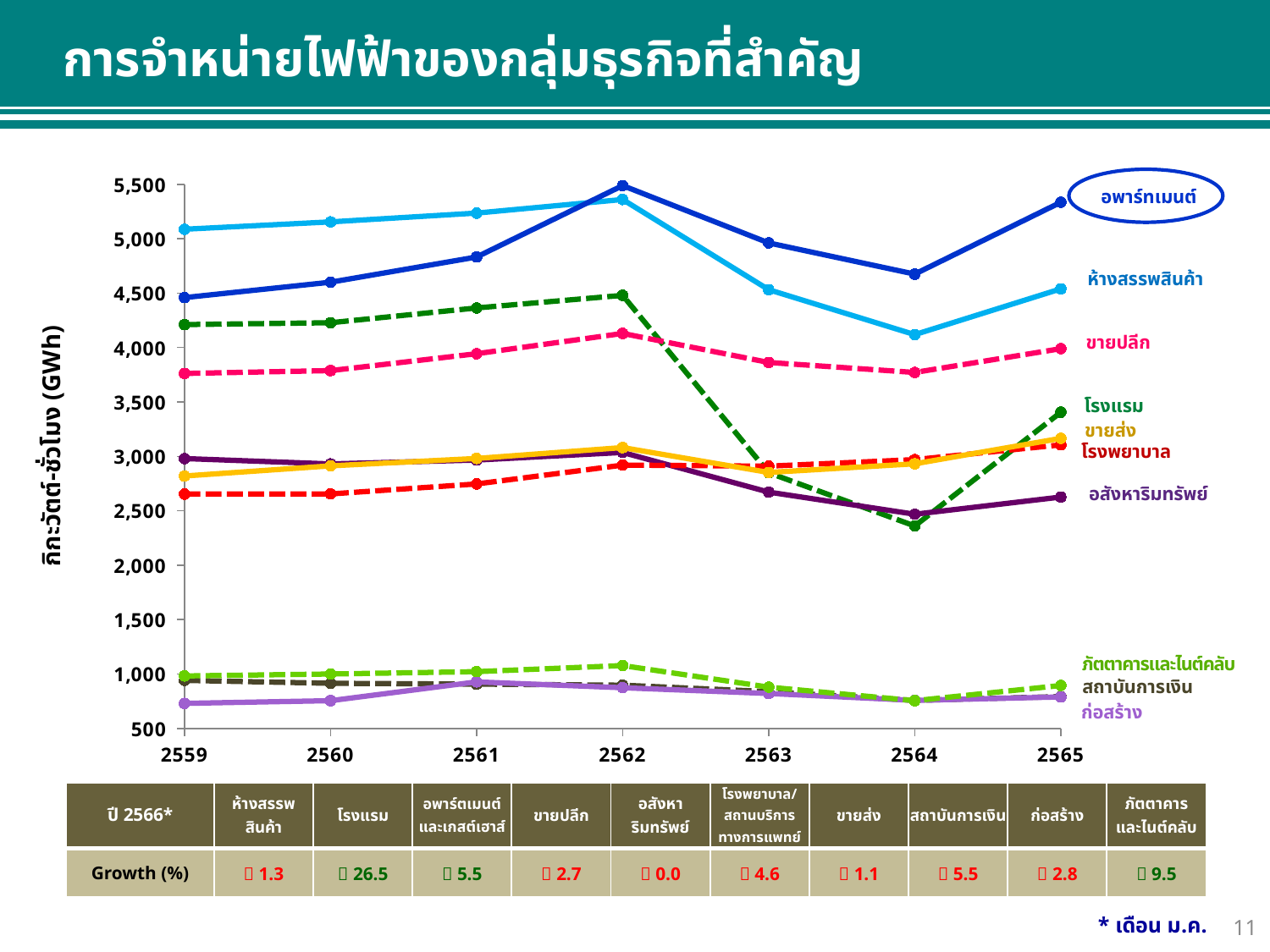
Does the value for อพาร์ทเมนต์ rise or fall from 2559 to 2562? rise Is the value for โรงแรม in 2564 greater or less than 2,500? less What kind of chart is shown on the slide? line chart How many years are plotted along the x axis of the chart? 7 Which business group has the lowest value in 2559? ก่อสร้าง Is the value for อพาร์ทเมนต์ in 2559 greater or less than 5,000? less Which business group has the highest value in 2565? อพาร์ทเมนต์ How many business groups (series) are plotted in the chart? 10 What is the label of the y axis of the chart? กิกะวัตต์-ชั่วโมง (GWh) In 2565, which is larger: โรงแรม or อสังหาริมทรัพย์? โรงแรม Is the value for ห้างสรรพสินค้า in 2561 greater or less than 5,000? greater In 2564, which is larger: ห้างสรรพสินค้า or ขายปลีก? ห้างสรรพสินค้า